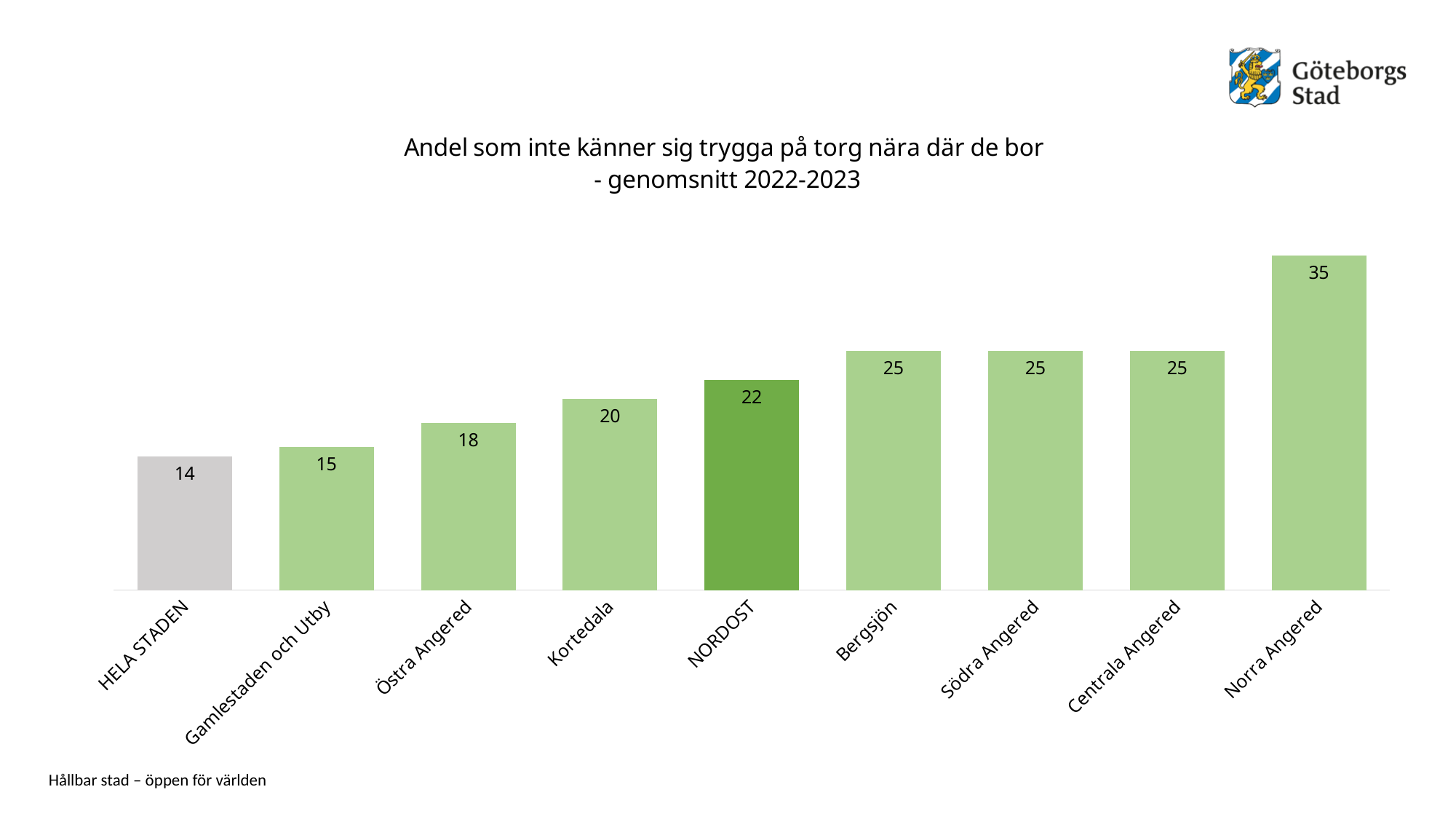
What is the value for HELA STADEN? 14 What is the value for NORDOST? 22 Do the values rise or fall from left to right along the x axis? rise What is the title of the chart? Andel som inte känner sig trygga på torg nära där de bor - genomsnitt 2022-2023 What is the value for Kortedala? 20 What is the difference between the values for Norra Angered and HELA STADEN? 21 Which is larger, the value for Gamlestaden och Utby or the value for Kortedala? Kortedala What kind of chart is this? bar chart How many categories are shown on the x axis? 9 Which category has the highest value? Norra Angered Which category has the lowest value? HELA STADEN What is the difference between the values for Bergsjön and Östra Angered? 7